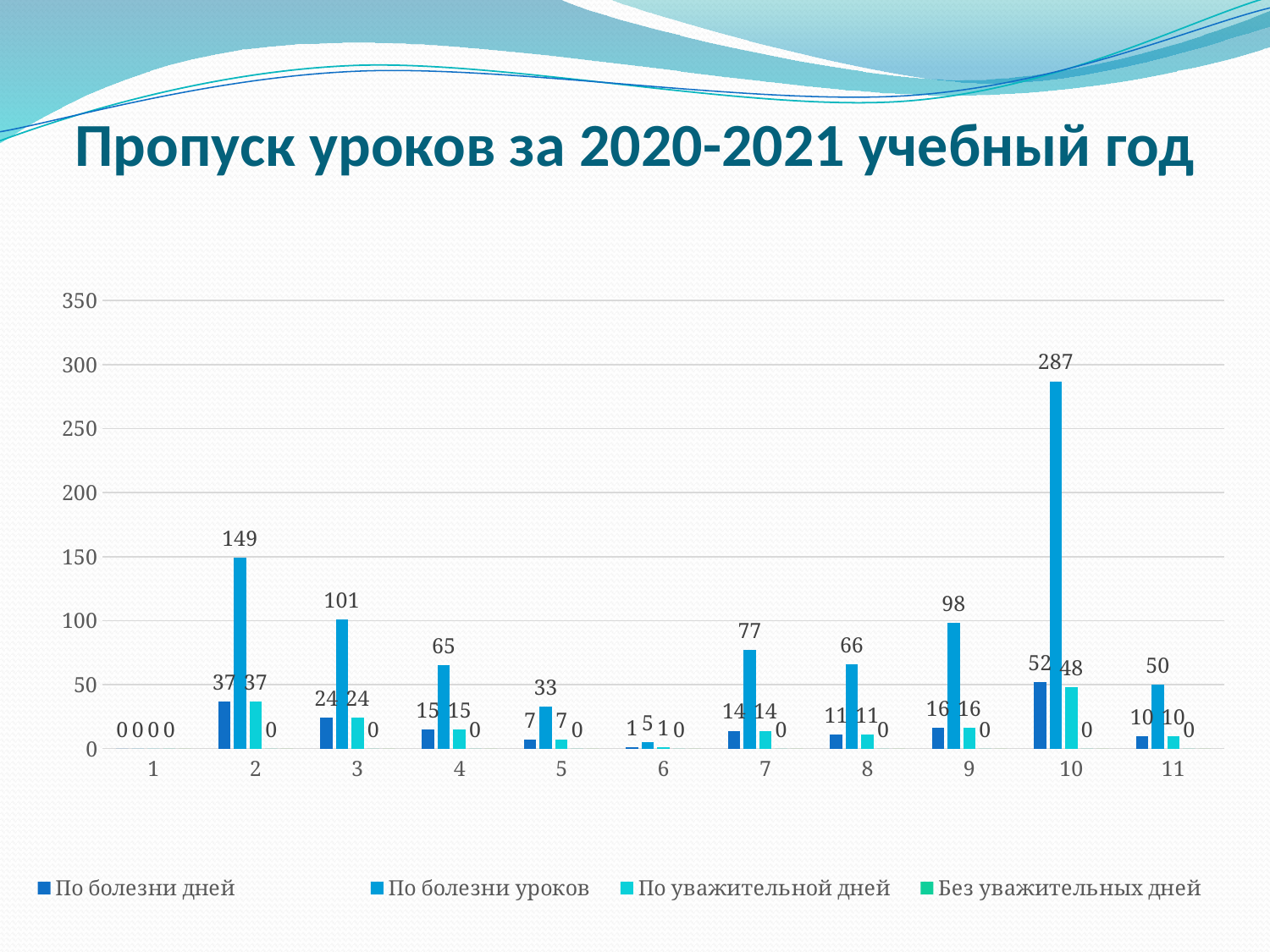
What is the value of 'По болезни уроков' for category 5? 33 How many categories are shown on the x axis? 11 What kind of chart is shown on the slide? Bar chart What is the difference between the 'По болезни уроков' values for categories 10 and 2? 138 Which category has the lowest value for 'По болезни уроков'? 1 What is the value of 'По болезни дней' for category 2? 37 How many series does the legend list? 4 What is the title of the chart? Пропуск уроков за 2020-2021 учебный год Which category has the highest value for 'По болезни уроков'? 10 What is the value of 'По болезни уроков' for category 10? 287 Which is larger: 'По болезни уроков' for category 3 or for category 9? Category 3 What is the value of 'По уважительной дней' for category 10? 48